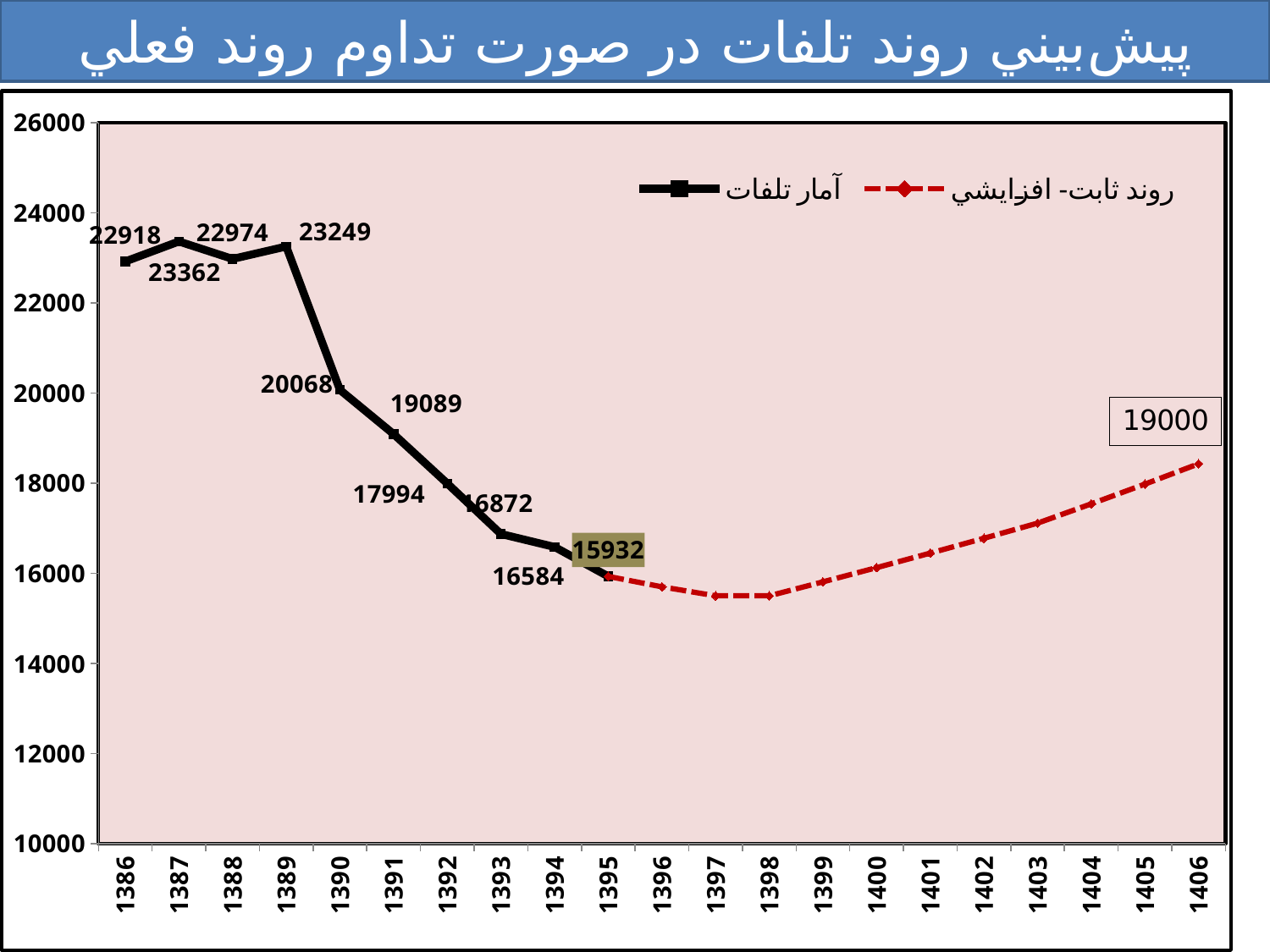
What is the difference between the آمار تلفات values for 1386 and 1395? 6986 Does the آمار تلفات series rise or fall from 1389 to 1395? fall Which year has the larger آمار تلفات value, 1388 or 1389? 1389 In which year does the آمار تلفات series reach its highest value? 1387 How many years are shown on the x axis? 21 What kind of chart is shown on the slide? line chart Is the value of the red dashed روند ثابت- افزايشي series for 1397 greater or less than 16000? less What is the value of the آمار تلفات series for 1395? 15932 What is the value of the آمار تلفات series for 1387? 23362 How many series does the legend list? 2 In which year does the آمار تلفات series reach its lowest labelled value? 1395 Is the value of the red dashed روند ثابت- افزايشي series for 1406 greater or less than 18000? greater